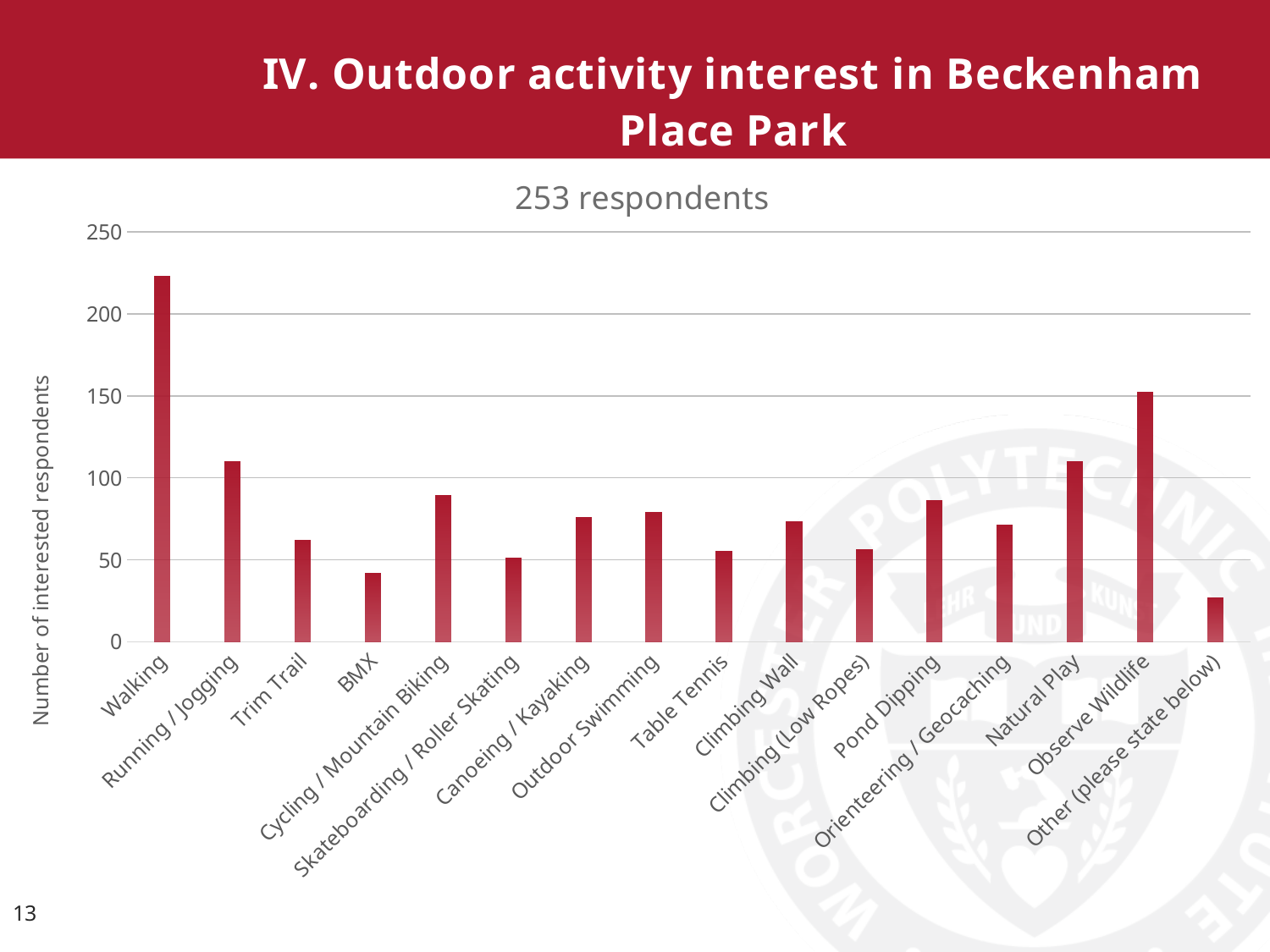
Is the value for BMX greater or less than 50? less What is the label on the vertical axis of the chart? Number of interested respondents Is the value for Walking greater or less than 200? greater Is the value for Observe Wildlife greater or less than 100? greater How many activity categories are plotted on the chart? 16 Which activity has the highest number of interested respondents? Walking Which activity has the lowest number of interested respondents? Other (please state below) Which has more interested respondents, Walking or Observe Wildlife? Walking What kind of chart is shown on the slide? Bar chart Which has more interested respondents, Trim Trail or BMX? Trim Trail What is the title of the chart? 253 respondents